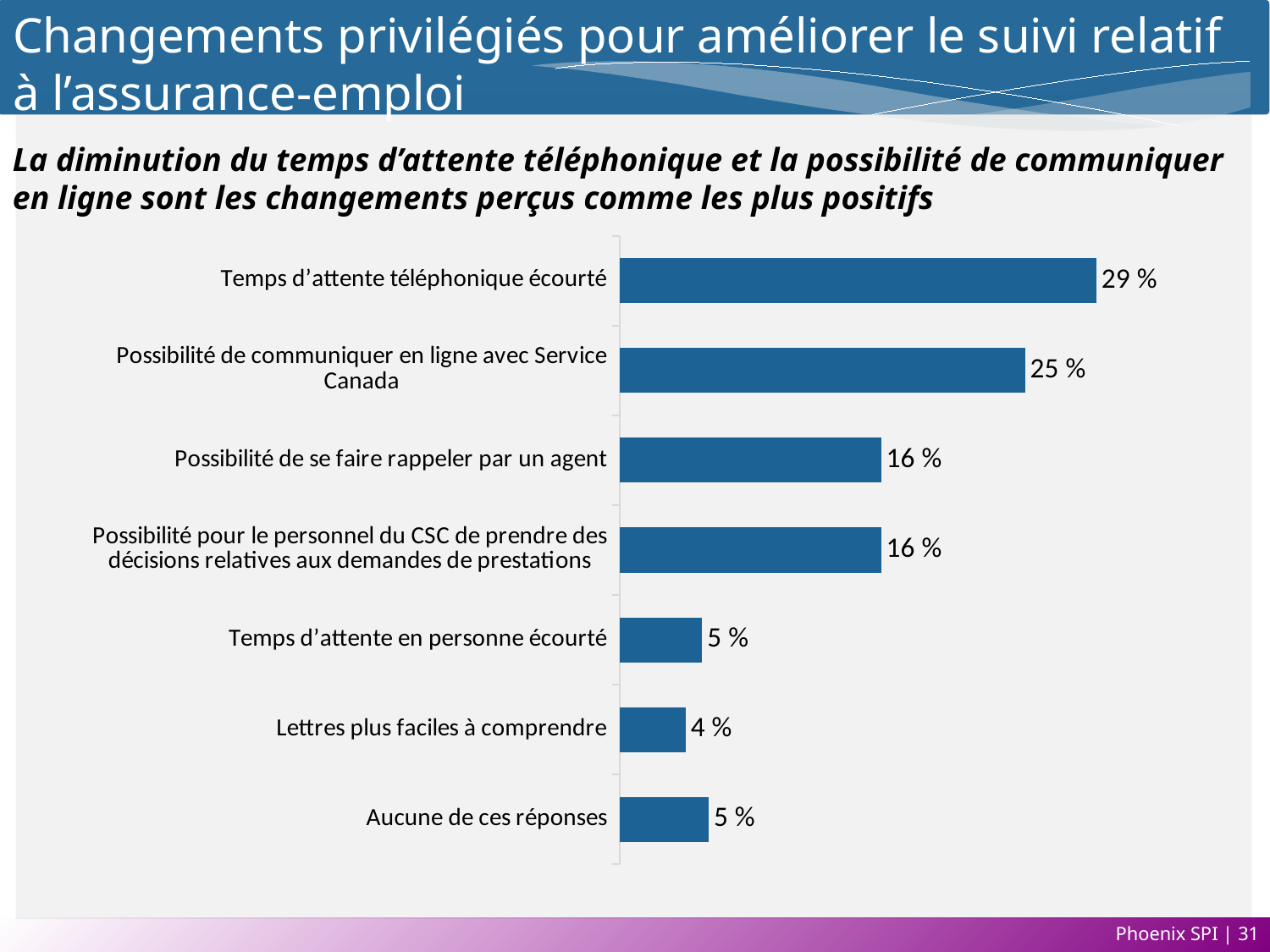
What is the value for "Lettres plus faciles à comprendre"? 4 % What is the difference between the values for "Possibilité de se faire rappeler par un agent" and "Temps d’attente en personne écourté"? 11 % What colour are the bars in the chart? Blue What is the difference between the values for "Temps d’attente téléphonique écourté" and "Possibilité de communiquer en ligne avec Service Canada"? 4 % Which category has the highest value? Temps d’attente téléphonique écourté Which is larger: the value for "Possibilité de se faire rappeler par un agent" or the value for "Temps d’attente en personne écourté"? Possibilité de se faire rappeler par un agent Which category has the lowest value? Lettres plus faciles à comprendre How many categories are shown in the chart? 7 What is the value for "Temps d’attente téléphonique écourté"? 29 % What is the value for "Aucune de ces réponses"? 5 % What is the value for "Possibilité de communiquer en ligne avec Service Canada"? 25 % What kind of chart is shown on the slide? Bar chart